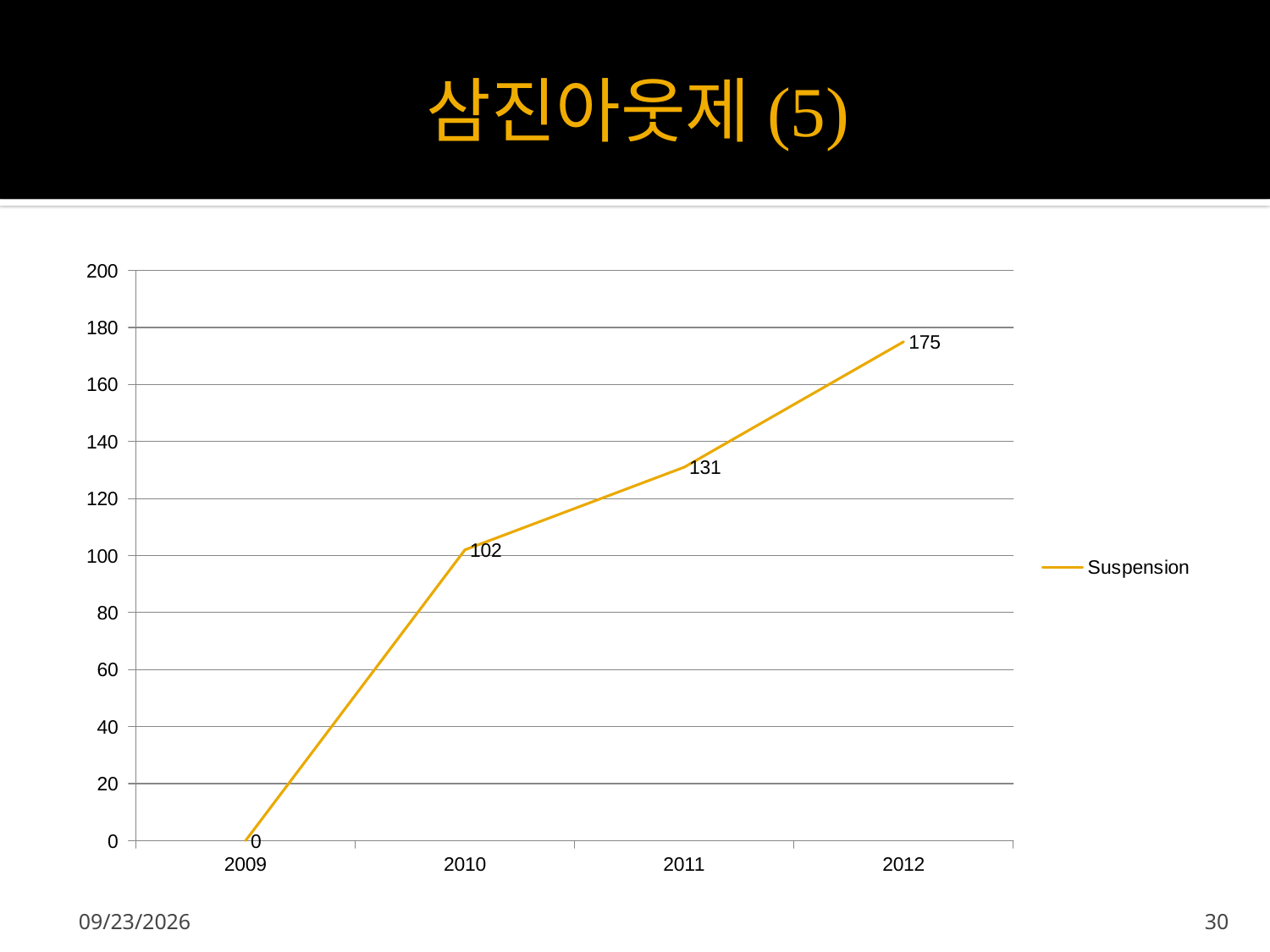
What is the Suspension value for 2012? 175 What is the difference between the Suspension values for 2011 and 2010? 29 What kind of chart is shown on the slide? line chart What is the Suspension value for 2011? 131 Which is larger, the Suspension value for 2010 or for 2011? 2011 Which year has the highest Suspension value? 2012 What is the difference between the Suspension values for 2012 and 2011? 44 How many series does the legend list? 1 How many years are plotted on the x axis? 4 What is the Suspension value for 2010? 102 Which year has the lowest Suspension value? 2009 What is the Suspension value for 2009? 0